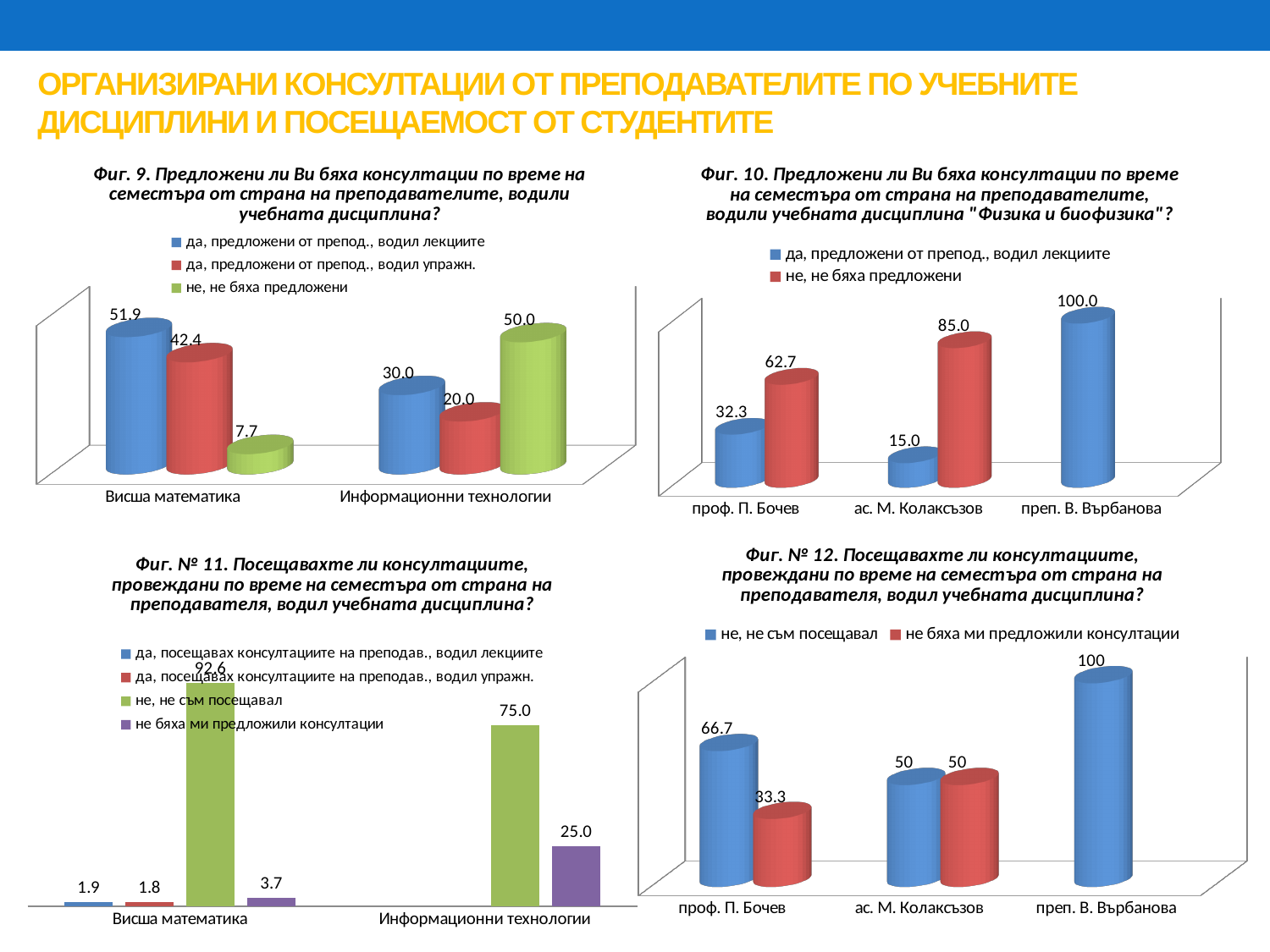
In Fig. 10 (top-right chart), which lecturer has the highest value for 'да, предложени от препод., водил лекциите'? преп. В. Върбанова In Fig. 9 (top-left chart), what is the value for 'не, не бяха предложени' for Информационни технологии? 50.0 In Fig. 10 (top-right chart), what is the value for 'не, не бяха предложени' for ас. М. Колаксъзов? 85.0 In Fig. 9 (top-left chart), what is the difference between the 'водил лекциите' and 'водил упражн.' values for Висша математика? 9.5 In Fig. 10 (top-right chart), which is larger for проф. П. Бочев: 'да, предложени от препод., водил лекциите' or 'не, не бяха предложени'? не, не бяха предложени In Fig. 12 (bottom-right chart), what is the value for 'не, не съм посещавал' for проф. П. Бочев? 66.7 How many categories are shown on the x axis of Fig. 10 (top-right chart)? 3 In Fig. 11 (bottom-left chart), what is the value for 'не, не съм посещавал' for Висша математика? 92.6 How many series does the legend of Fig. 9 (top-left chart) list? 3 What type of chart is Fig. 12 (bottom-right chart)? bar chart In Fig. 9 (top-left chart), what is the value for 'да, предложени от препод., водил лекциите' for Висша математика? 51.9 In Fig. 11 (bottom-left chart), what is the value for 'не бяха ми предложили консултации' for Информационни технологии? 25.0